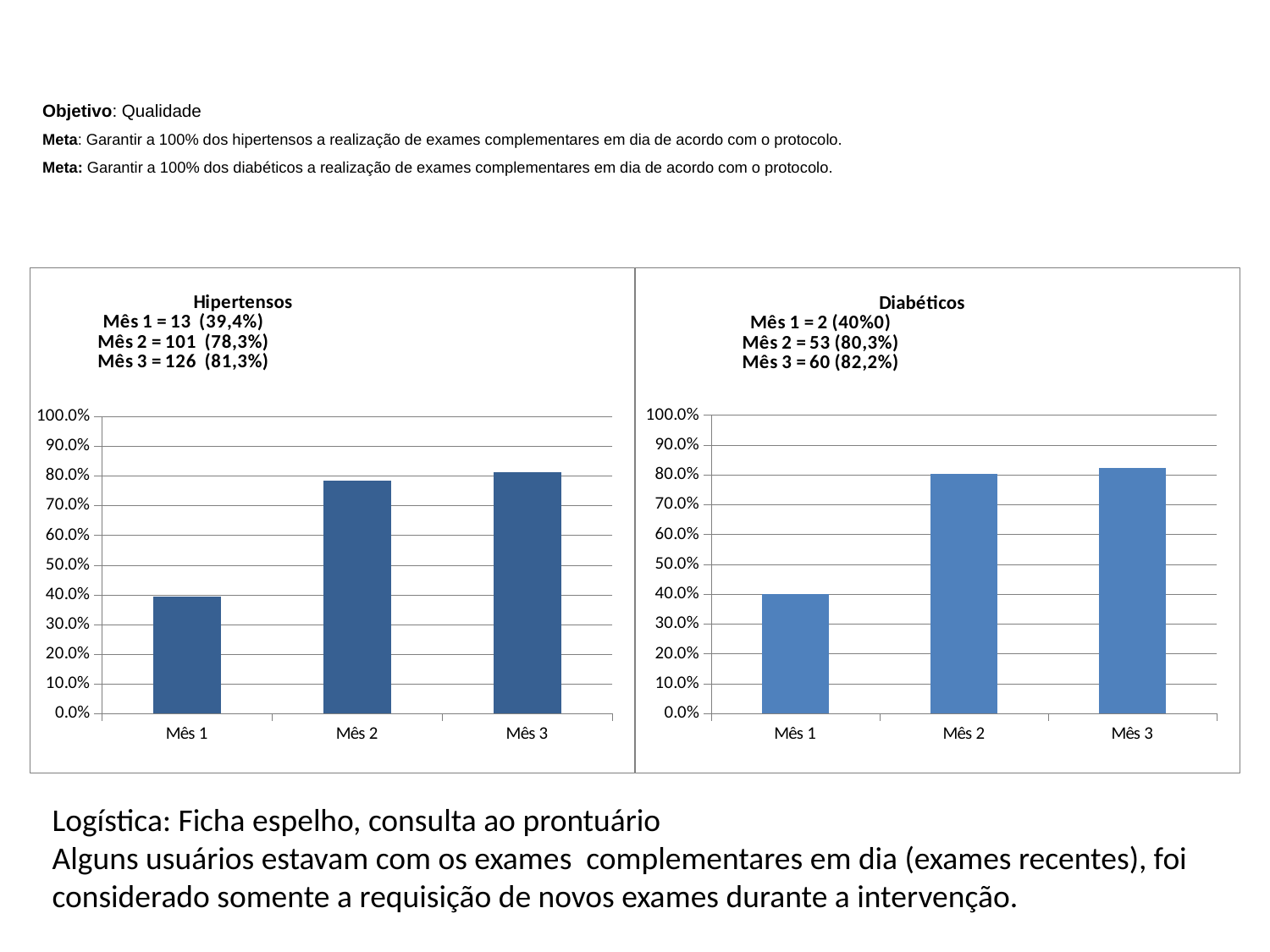
In the Diabéticos chart, is the value for Mês 2 greater or less than 70%? greater In the Diabéticos chart, which month has the highest value? Mês 3 In the Diabéticos chart, what is the value for Mês 3? 82,2% What is the title of the chart on the right side of the slide? Diabéticos How many bars are shown in the Diabéticos chart? 3 In the Hipertensos chart, what is the difference in percentage points between Mês 3 and Mês 2? 3 percentage points In the Hipertensos chart, which month has the lowest value? Mês 1 In the Diabéticos chart, do the values rise or fall from Mês 1 to Mês 3? rise What kind of chart is the Hipertensos chart? bar chart In the Hipertensos chart, is the value for Mês 1 greater or less than 50%? less In the Hipertensos chart, which is larger, the value for Mês 1 or the value for Mês 2? Mês 2 In the Hipertensos chart, what is the value for Mês 2? 78,3%